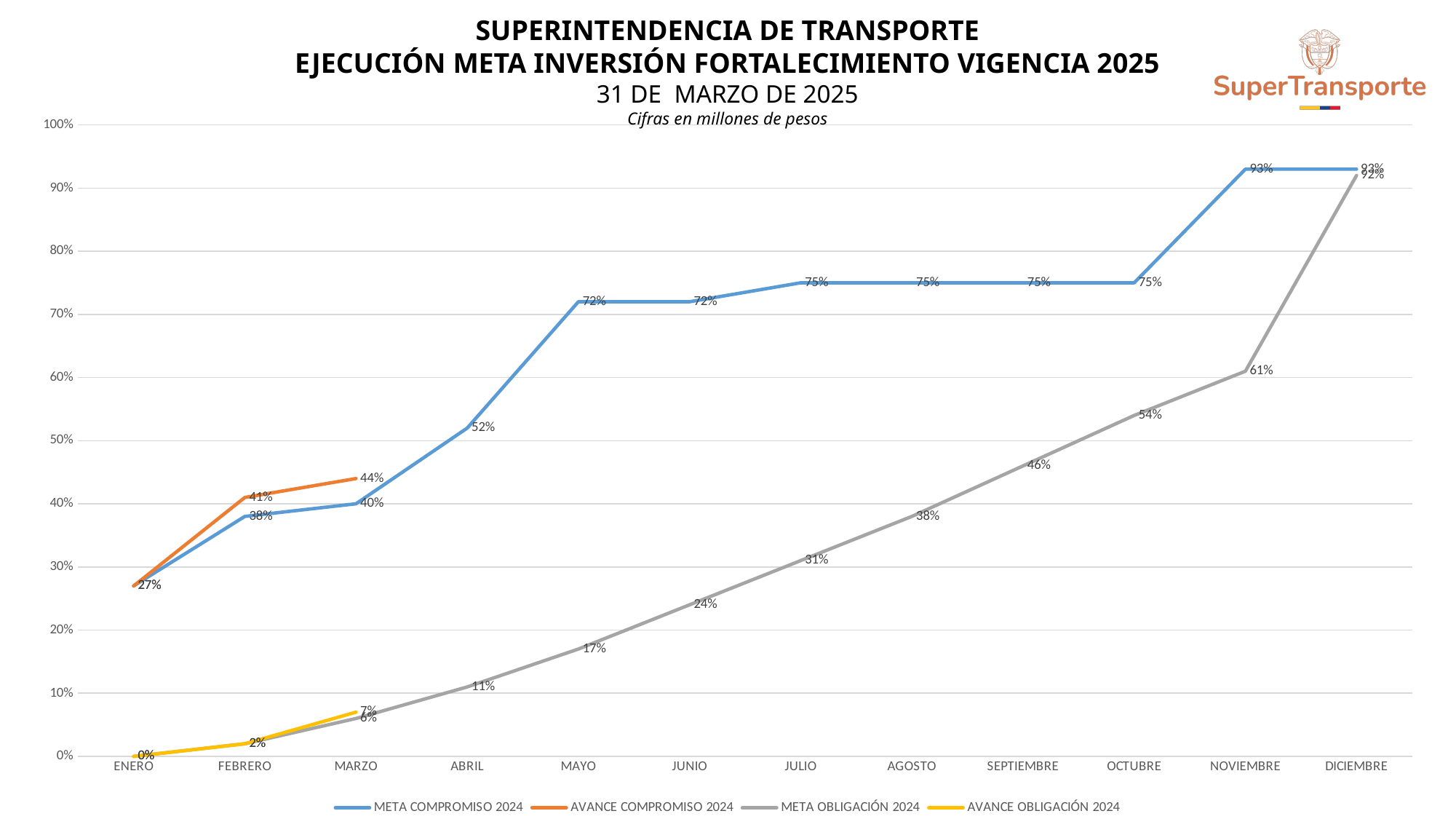
Does META OBLIGACIÓN 2024 rise or fall from ENERO to DICIEMBRE? Rise What is the value of META OBLIGACIÓN 2024 in JULIO? 31% What is the value of AVANCE COMPROMISO 2024 in MARZO? 44% In which month does META OBLIGACIÓN 2024 reach its highest value? DICIEMBRE What is the date shown in the chart title? 31 DE MARZO DE 2025 What is the value of AVANCE OBLIGACIÓN 2024 in MARZO? 7% What is the value of META COMPROMISO 2024 in ABRIL? 52% What is the difference between AVANCE COMPROMISO 2024 and META COMPROMISO 2024 in MARZO? 4% What kind of chart is shown on the slide? Line chart How many months are shown on the x axis? 12 How many series does the legend list? 4 Which is larger in FEBRERO: AVANCE COMPROMISO 2024 or META COMPROMISO 2024? AVANCE COMPROMISO 2024